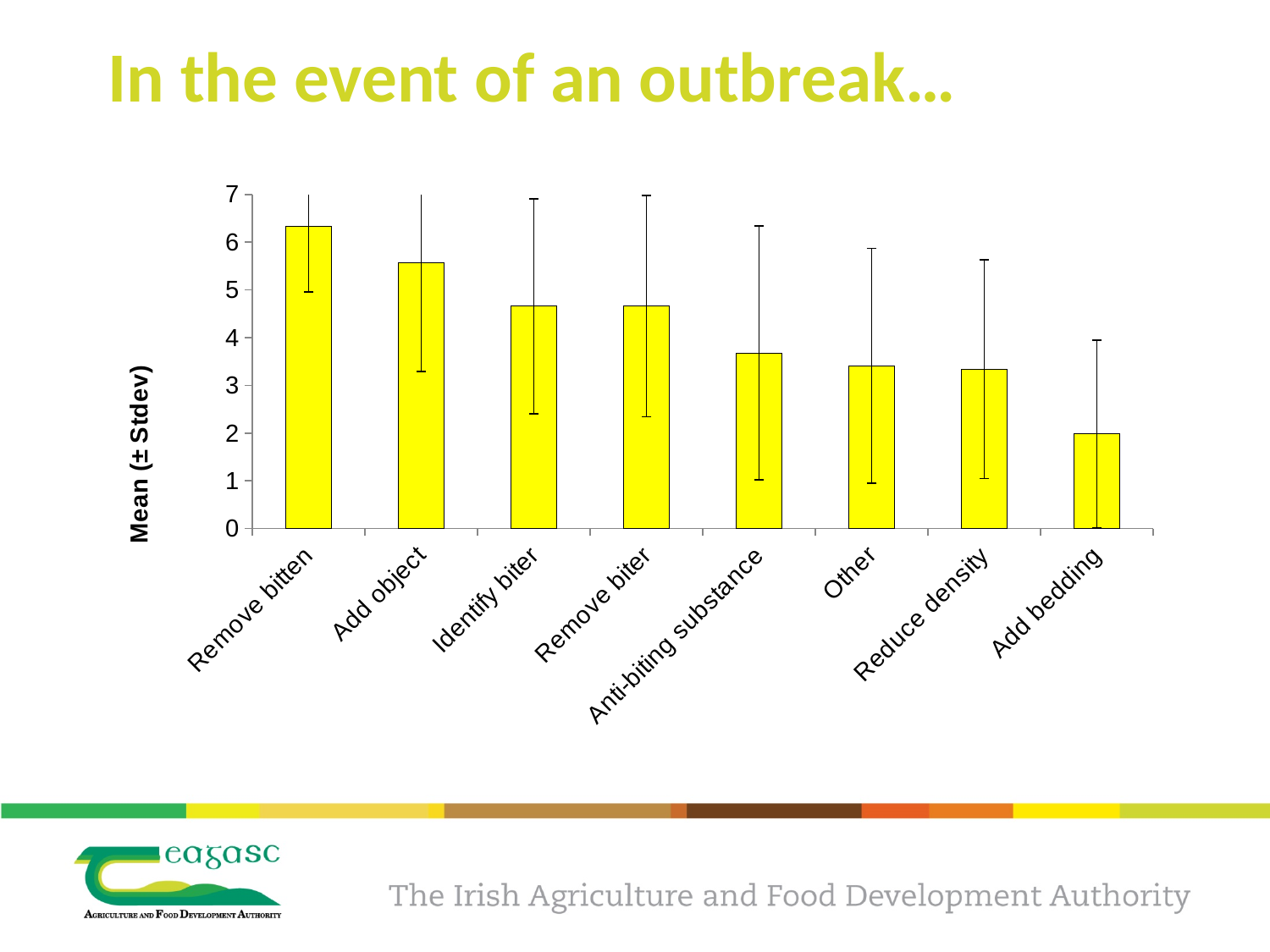
Which category has the highest mean value? Remove bitten What kind of chart is shown on the slide? bar chart Which category has the lowest mean value? Add bedding Is the value for Add bedding greater or less than 3? less What is the label on the y axis of the chart? Mean (± Stdev) Is the value for Add object greater or less than 5? greater How many categories are shown on the x axis of the chart? 8 Is the value for Other greater or less than 3? greater Do the bar values generally rise or fall from left to right along the x axis? fall Which is larger, the value for Add object or the value for Reduce density? Add object